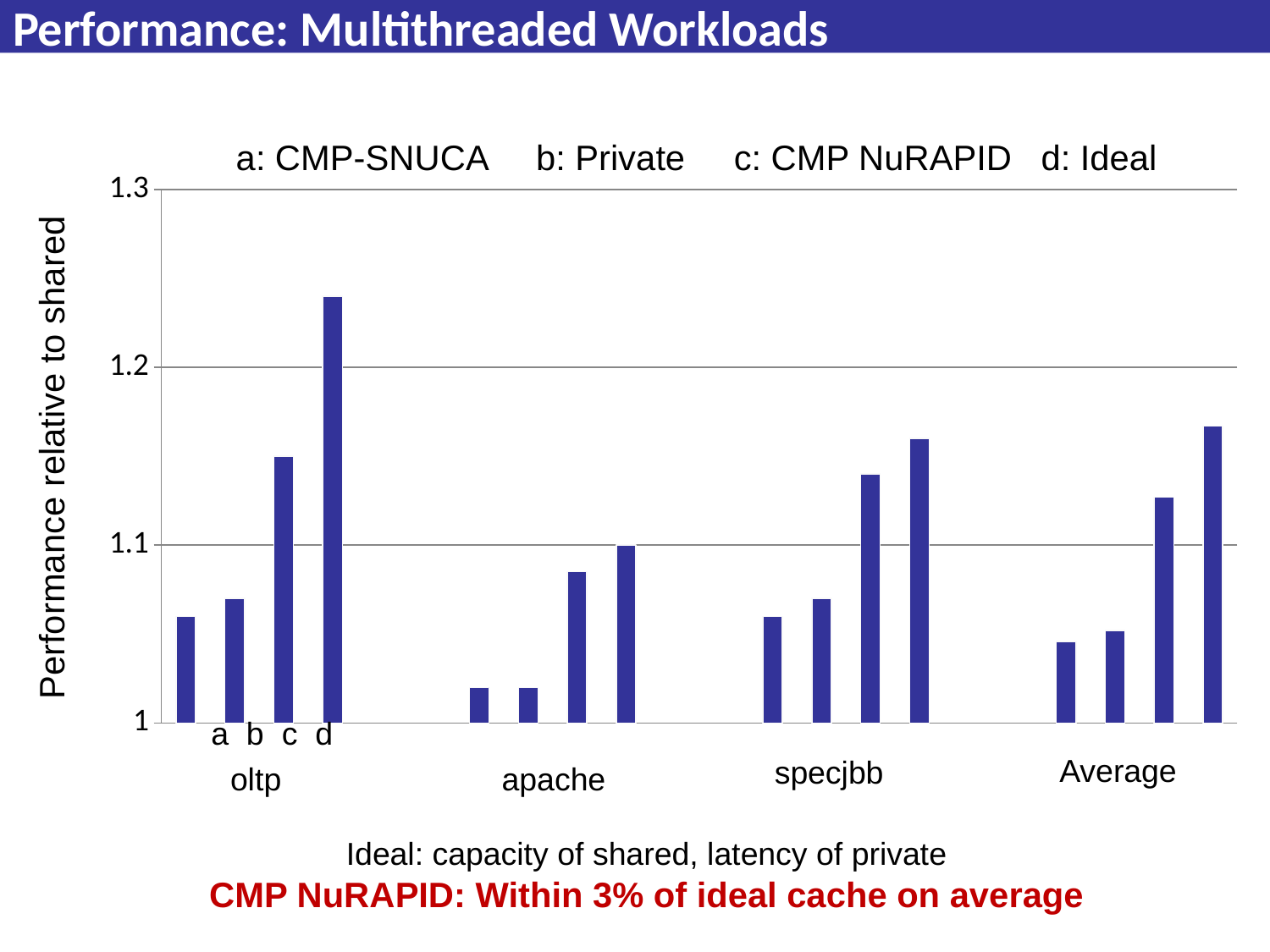
According to the legend, what does bar label c stand for? CMP NuRAPID Is the value for bar a (CMP-SNUCA) in the apache group greater or less than 1.1? less Which workload has the tallest bar in the chart? oltp How many workload groups are shown along the x axis? 4 Is the value for bar c (CMP NuRAPID) in the oltp group greater or less than 1.1? greater What kind of chart is shown on the slide? bar chart What is the label on the y axis? Performance relative to shared Is the value for bar d (Ideal) in the Average group greater or less than 1.2? less Within the oltp group, do the bars rise or fall from a to d? rise How many bars are plotted in each workload group? 4 In the specjbb group, which is larger: bar c (CMP NuRAPID) or bar b (Private)? bar c (CMP NuRAPID)